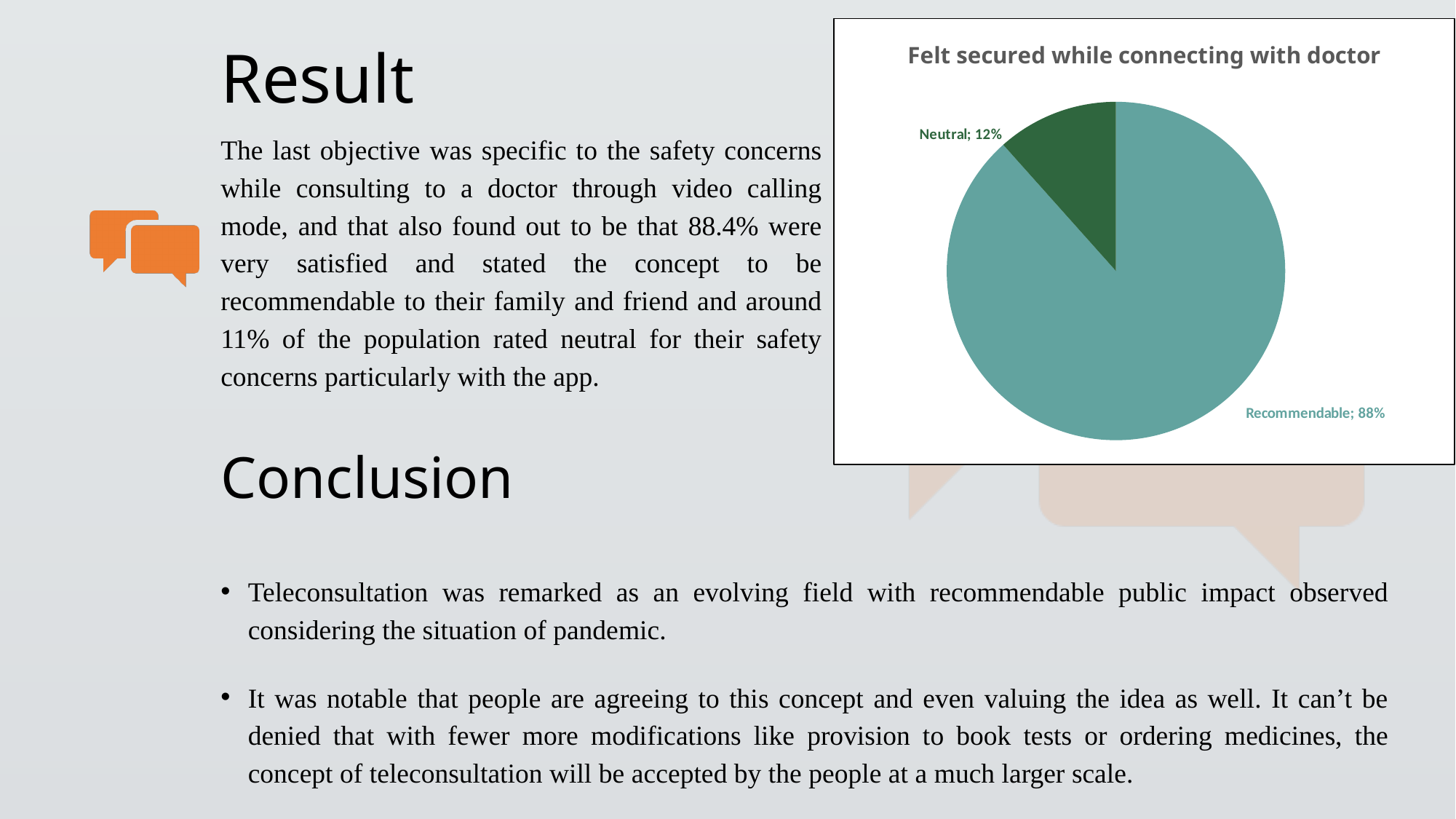
What colour is the Neutral slice of the pie chart? dark green Which is larger, the Neutral slice or the Recommendable slice? Recommendable Which slice of the pie chart is the largest? Recommendable Which slice of the pie chart is the smallest? Neutral What share of the pie is labelled Neutral? 12% What is the title of the pie chart? Felt secured while connecting with doctor What is the difference in percentage points between the Recommendable and Neutral slices? 76 What kind of chart is shown on the slide? pie chart What share of the pie is labelled Recommendable? 88% How many slices does the pie chart have? 2